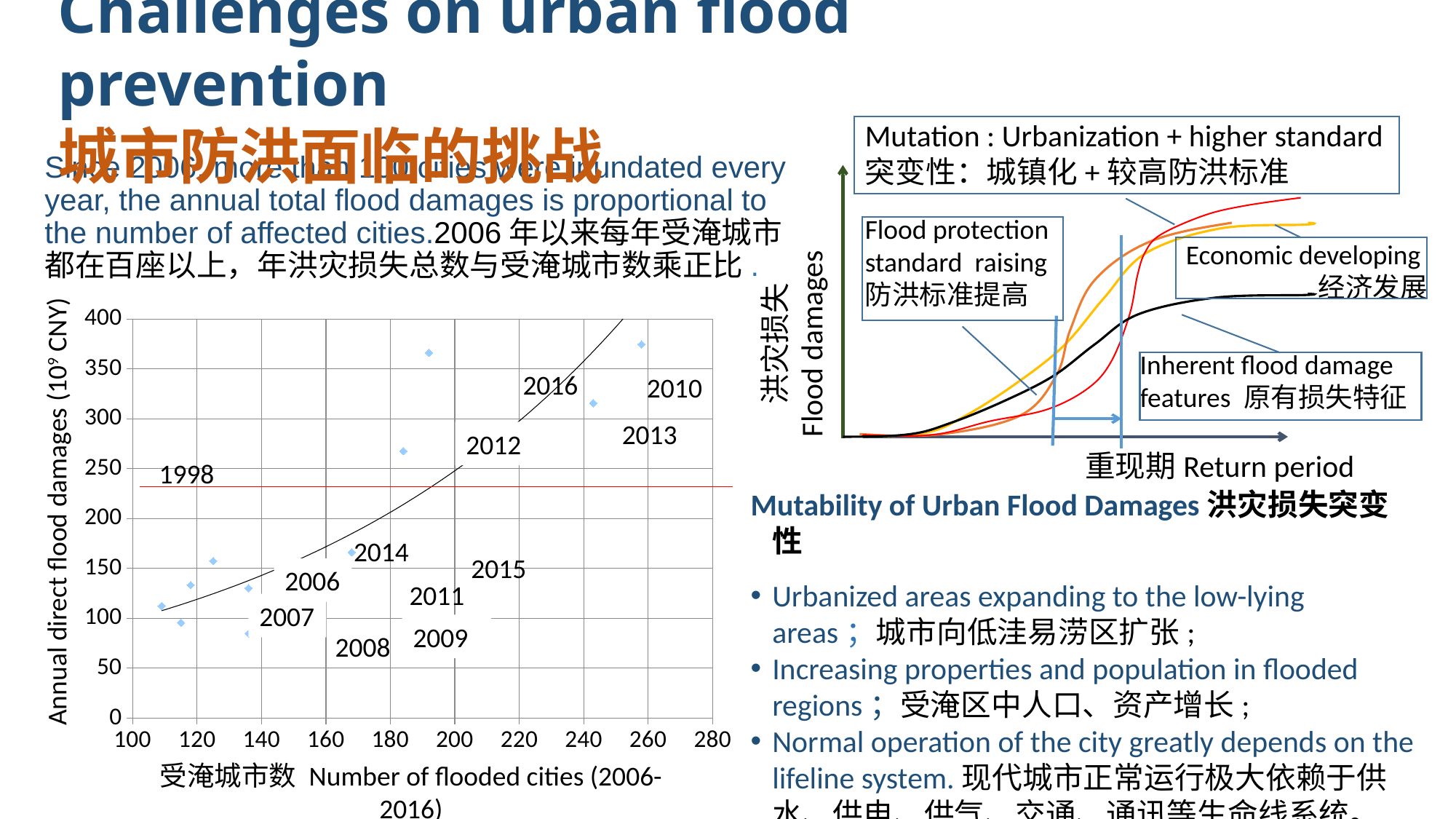
What unit is given in the y-axis title of the left scatter chart? 10⁹ CNY In the left scatter chart, is the annual direct flood damage for the point labelled 2013 greater or less than 300? greater In the left scatter chart, which year's point has the highest annual direct flood damages? 2010 In the left scatter chart, is the value of the red horizontal line labelled 1998 greater or less than 250? less In the left scatter chart, is the annual direct flood damage for the point labelled 2010 greater or less than 350? greater What is the x-axis label of the right chart titled Mutability of Urban Flood Damages? 重现期 Return period In the right chart titled Mutability of Urban Flood Damages, how many curves are drawn? 4 In the left scatter chart, do annual direct flood damages generally rise or fall as the number of flooded cities increases? rise What is the x-axis title of the left scatter chart? 受淹城市数 Number of flooded cities (2006-2016) What kind of chart is the left chart plotting annual direct flood damages against the number of flooded cities? scatter chart In the left scatter chart, how many data points are plotted? 11